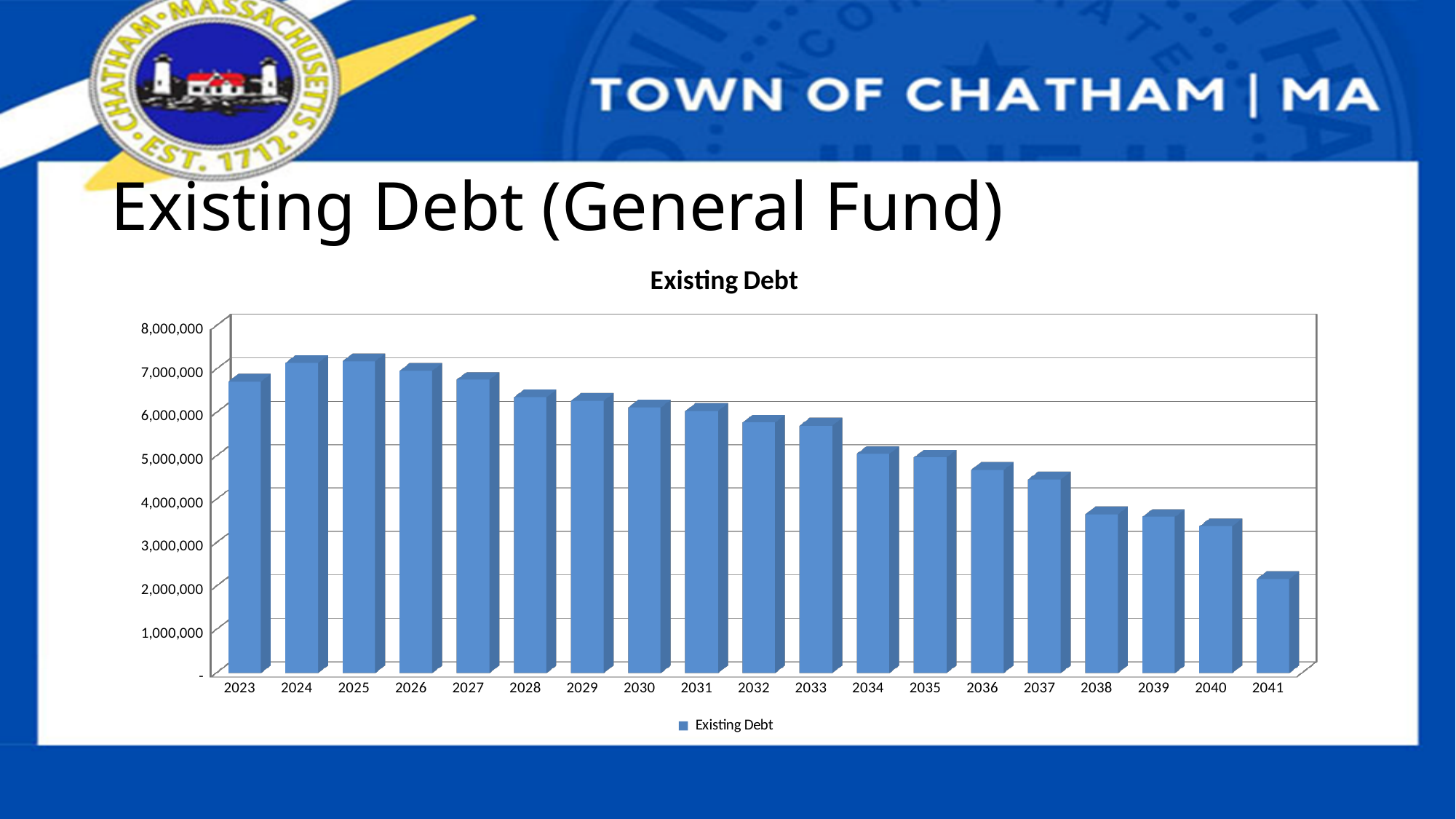
What kind of chart is shown on the slide? Bar chart Is the existing debt for 2032 greater or less than 6,000,000? less Do the existing debt values generally rise or fall from 2025 to 2041? Fall Which year has the lowest existing debt in the chart? 2041 How many years are plotted on the x axis of the Existing Debt chart? 19 Is the existing debt for 2036 greater or less than 5,000,000? less Which year has the larger existing debt, 2030 or 2035? 2030 Is the existing debt for 2040 greater or less than 3,000,000? greater What is the title of the chart on the slide? Existing Debt How many series does the legend of the Existing Debt chart list? 1